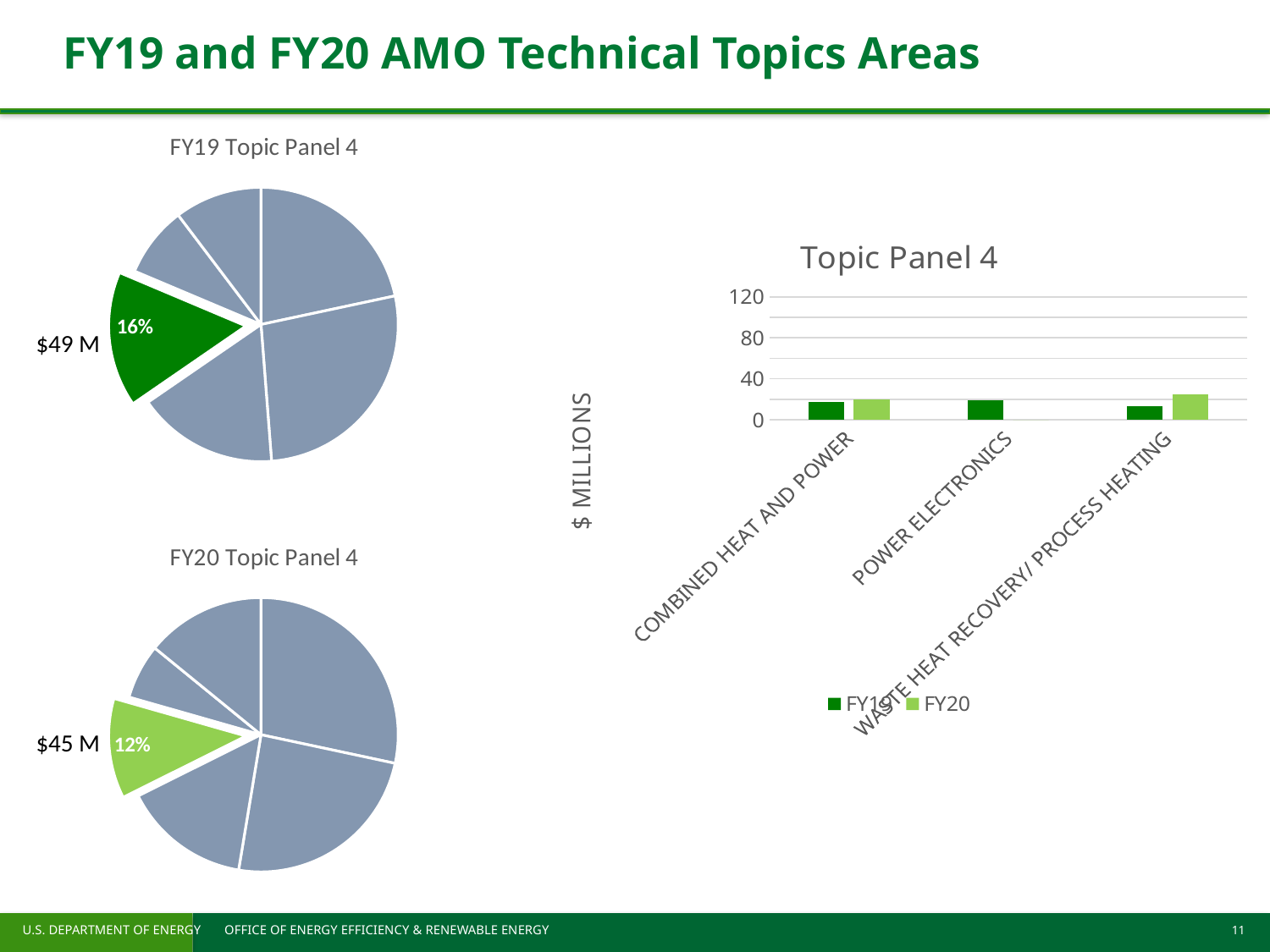
In the FY19 Topic Panel 4 pie chart, what dollar amount is labeled next to the highlighted slice? $49 M In the Topic Panel 4 bar chart, what is the label on the vertical axis? $ MILLIONS In the Topic Panel 4 bar chart, how many categories are shown on the x axis? 3 What kind of chart is the Topic Panel 4 chart on the right of the slide? Bar chart In the Topic Panel 4 bar chart, is the FY19 value for Combined Heat and Power greater or less than 40? less In the FY20 Topic Panel 4 pie chart, what percentage is shown on the highlighted green slice? 12% In the Topic Panel 4 bar chart, how many series does the legend list? 2 In the FY19 Topic Panel 4 pie chart, what percentage is shown on the highlighted green slice? 16% In the FY20 Topic Panel 4 pie chart, what dollar amount is labeled next to the highlighted slice? $45 M In the Topic Panel 4 bar chart, for Waste Heat Recovery/Process Heating, which series has the larger value, FY19 or FY20? FY20 What is the difference in percentage points between the highlighted slice in the FY19 Topic Panel 4 pie and the highlighted slice in the FY20 Topic Panel 4 pie? 4 percentage points Which pie chart has the larger highlighted slice percentage, FY19 Topic Panel 4 or FY20 Topic Panel 4? FY19 Topic Panel 4